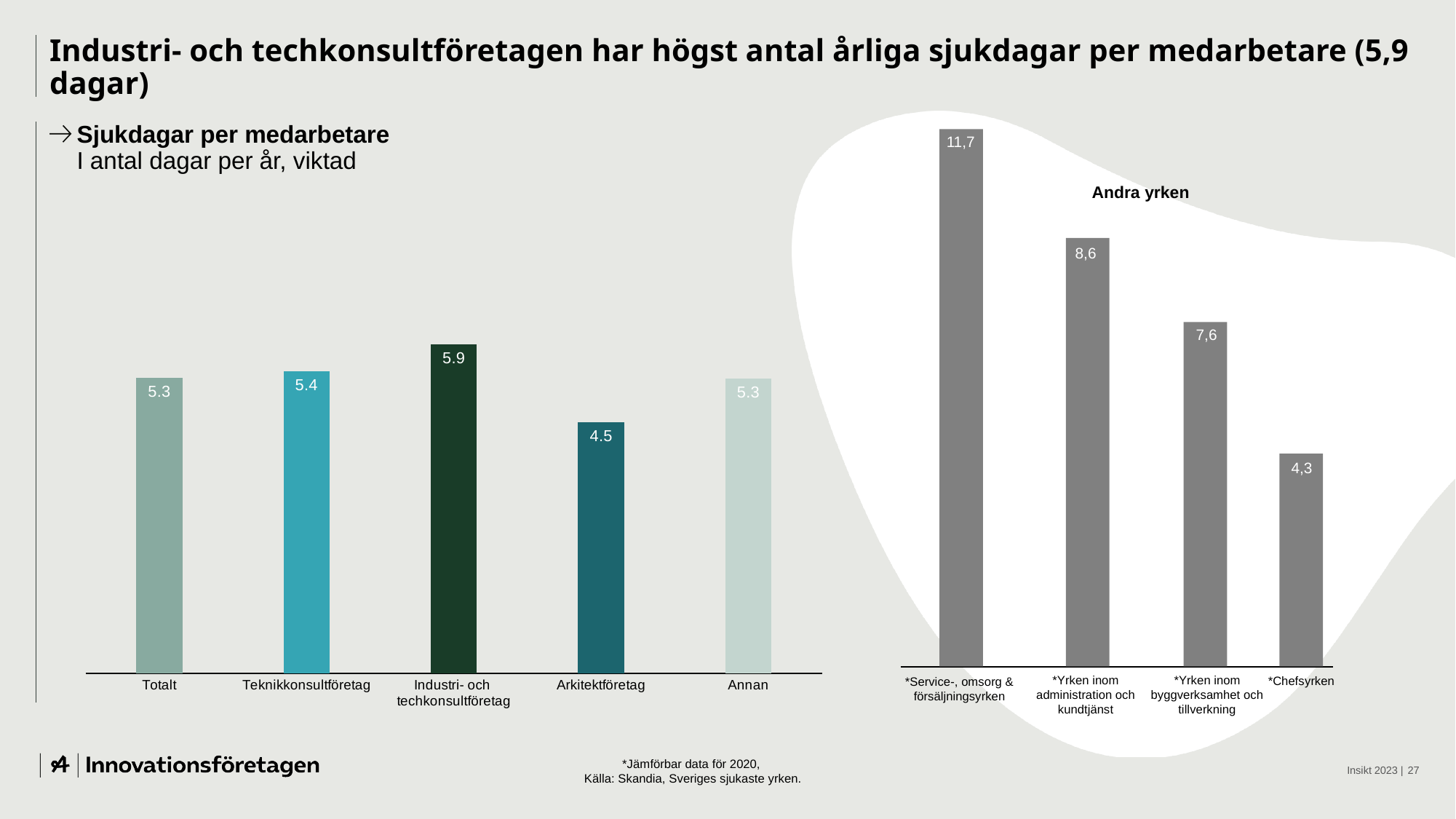
In the left chart (Sjukdagar per medarbetare), which category has the highest value? Industri- och techkonsultföretag What type of chart is the left chart (Sjukdagar per medarbetare)? bar chart In the right chart (Andra yrken), do the values rise or fall from left to right? fall In the left chart (Sjukdagar per medarbetare), which category has the lowest value? Arkitektföretag In the left chart (Sjukdagar per medarbetare), what is the value for Industri- och techkonsultföretag? 5.9 In the left chart (Sjukdagar per medarbetare), what is the difference between Industri- och techkonsultföretag and Arkitektföretag? 1.4 In the left chart (Sjukdagar per medarbetare), what is the value for Arkitektföretag? 4.5 In the right chart (Andra yrken), which category has the highest value? *Service-, omsorg & försäljningsyrken In the left chart (Sjukdagar per medarbetare), how many categories are shown? 5 In the right chart (Andra yrken), what is the value for *Chefsyrken? 4,3 In the right chart (Andra yrken), what is the difference between *Yrken inom administration och kundtjänst and *Yrken inom byggverksamhet och tillverkning? 1,0 In the right chart (Andra yrken), what is the value for *Service-, omsorg & försäljningsyrken? 11,7